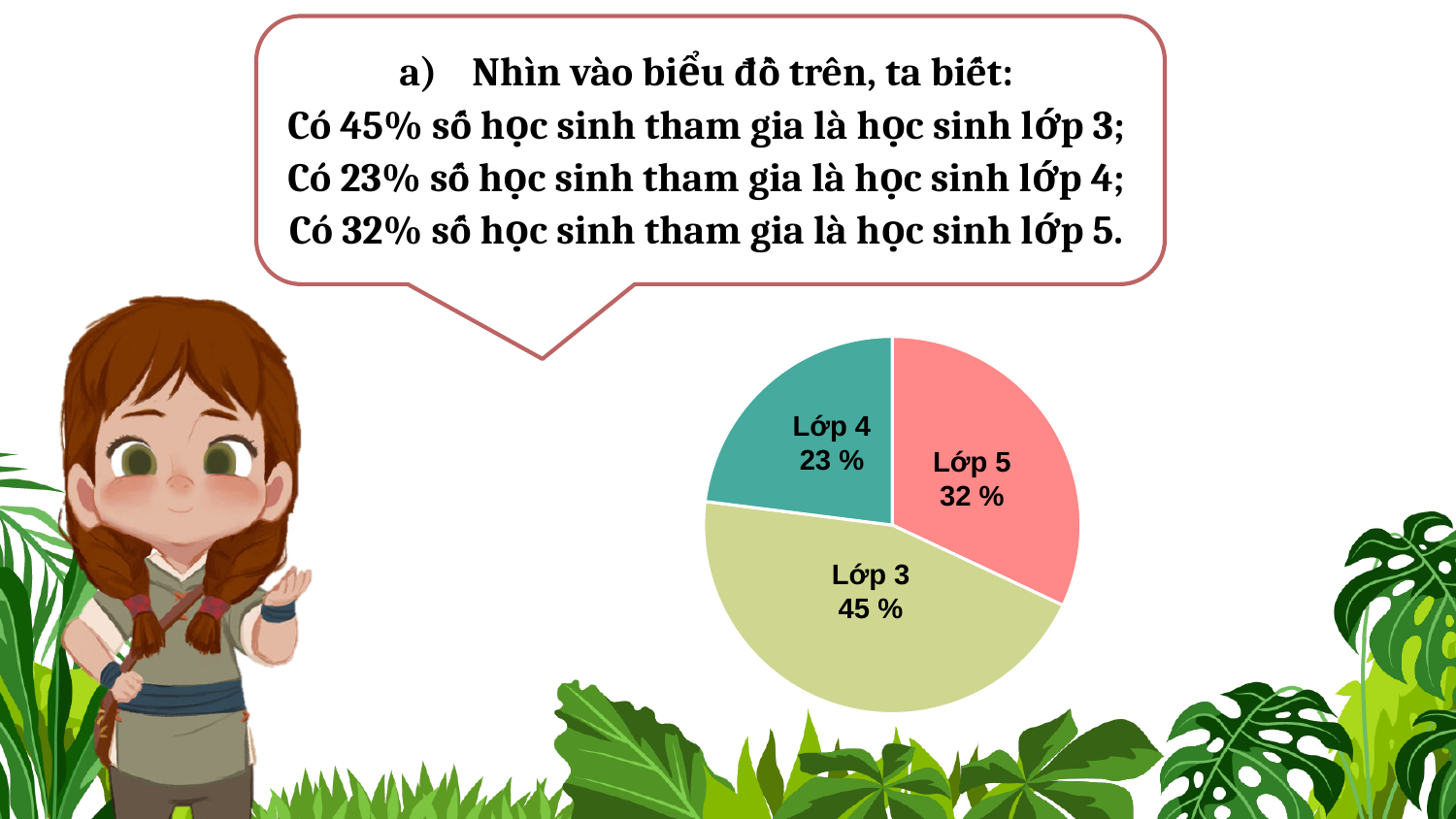
What is the difference in percentage points between Lớp 5 and Lớp 4? 9 What percentage is shown for Lớp 5 in the pie chart? 32 % What percentage is shown for Lớp 3 in the pie chart? 45 % Which class has the smallest slice of the pie chart? Lớp 4 What is the difference in percentage points between Lớp 3 and Lớp 4? 22 Which class has the largest slice of the pie chart? Lớp 3 What percentage is shown for Lớp 4 in the pie chart? 23 % Which slice is larger, Lớp 5 or Lớp 4? Lớp 5 How many slices does the pie chart have? 3 What kind of chart is shown on the slide? pie chart What colour is the Lớp 4 slice in the pie chart? teal What colour is the Lớp 5 slice in the pie chart? pink